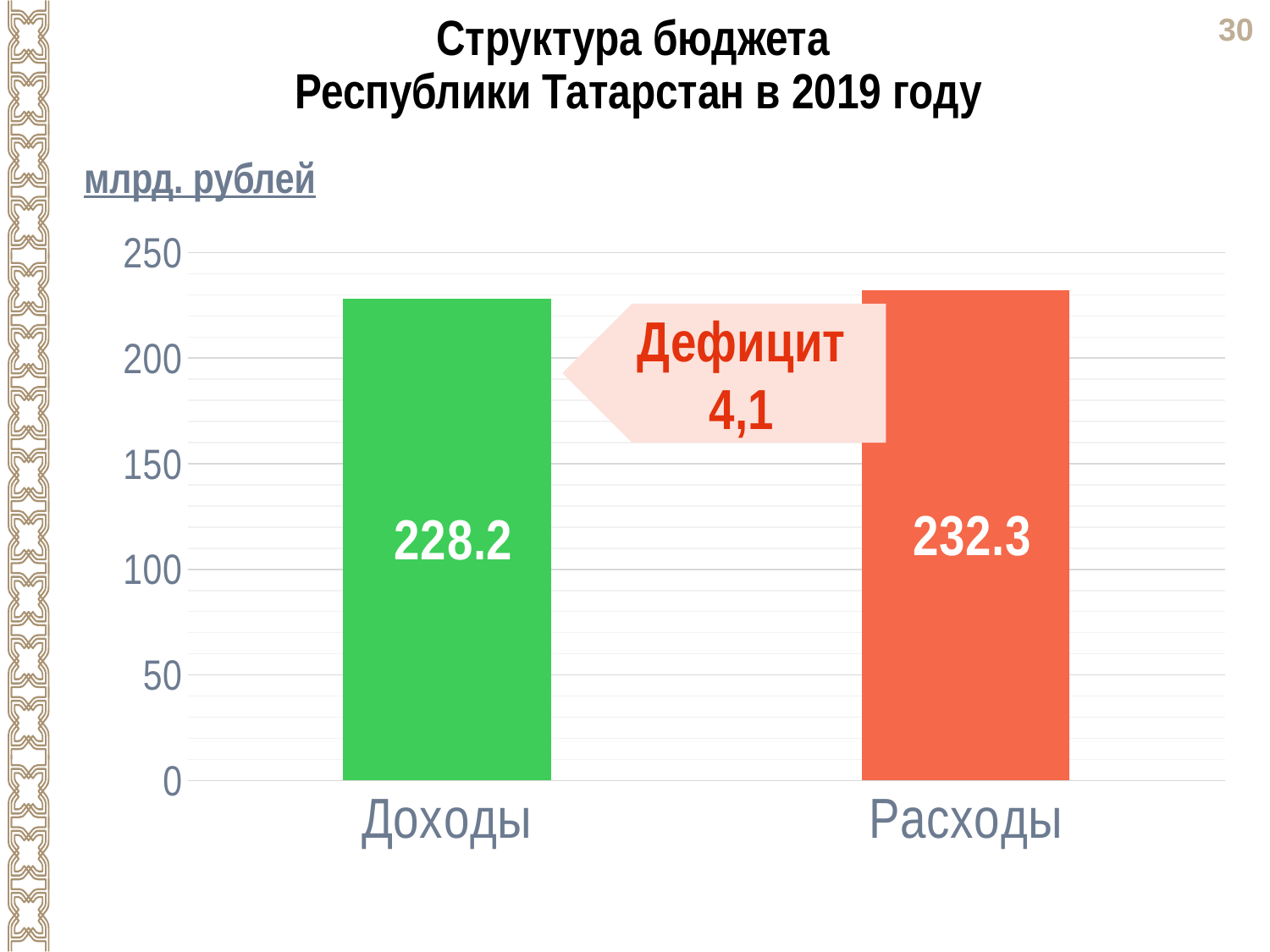
How many categories are shown on the chart? 2 Which category has the highest value? Расходы Which category has the higher value, Доходы or Расходы? Расходы What kind of chart is shown on the slide? bar chart What is the value for Расходы? 232.3 Is the value for Доходы greater or less than 200? greater What unit is indicated for the values on the chart? млрд. рублей What is the difference between Расходы and Доходы? 4.1 What is the value for Доходы? 228.2 Which category has the lowest value? Доходы Is the value for Расходы greater or less than 250? less What is the title of the chart? Структура бюджета Республики Татарстан в 2019 году